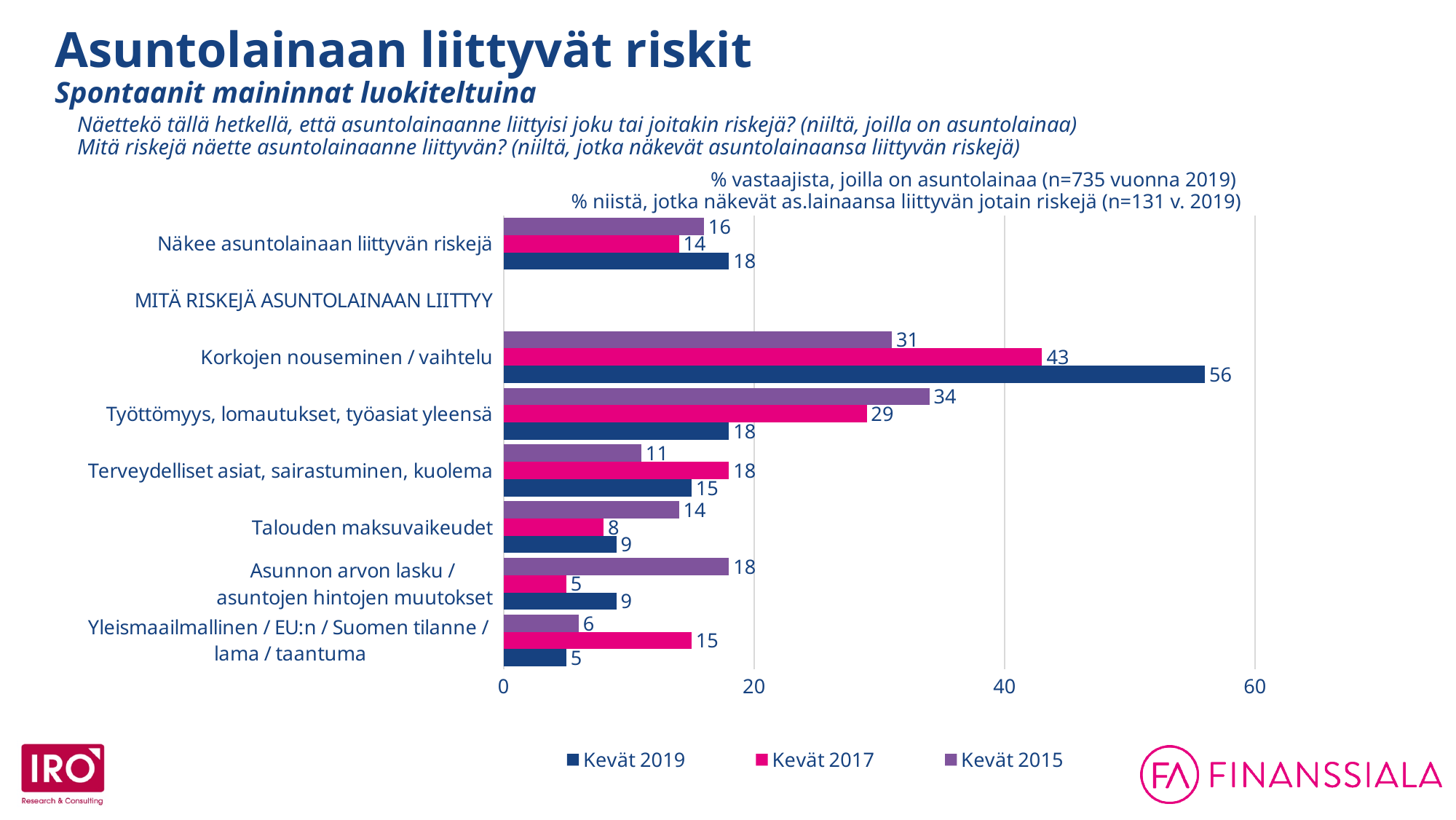
What is the Kevät 2017 value for Asunnon arvon lasku / asuntojen hintojen muutokset? 5 Which risk category has the lowest Kevät 2017 value? Asunnon arvon lasku / asuntojen hintojen muutokset Is the Kevät 2017 value for Korkojen nouseminen / vaihtelu greater or less than 40? greater What kind of chart is shown on the slide? Bar chart What is the Kevät 2015 value for Työttömyys, lomautukset, työasiat yleensä? 34 How did the value for Korkojen nouseminen / vaihtelu change from Kevät 2015 to Kevät 2019? It rose How many series does the legend list? 3 What is the difference between the Kevät 2019 and Kevät 2015 values for Korkojen nouseminen / vaihtelu? 25 What is the Kevät 2019 value for Korkojen nouseminen / vaihtelu? 56 Which colour represents Kevät 2017 in the chart? Pink For Työttömyys, lomautukset, työasiat yleensä, which is larger: the Kevät 2017 value or the Kevät 2019 value? Kevät 2017 Which risk category has the highest Kevät 2019 value? Korkojen nouseminen / vaihtelu